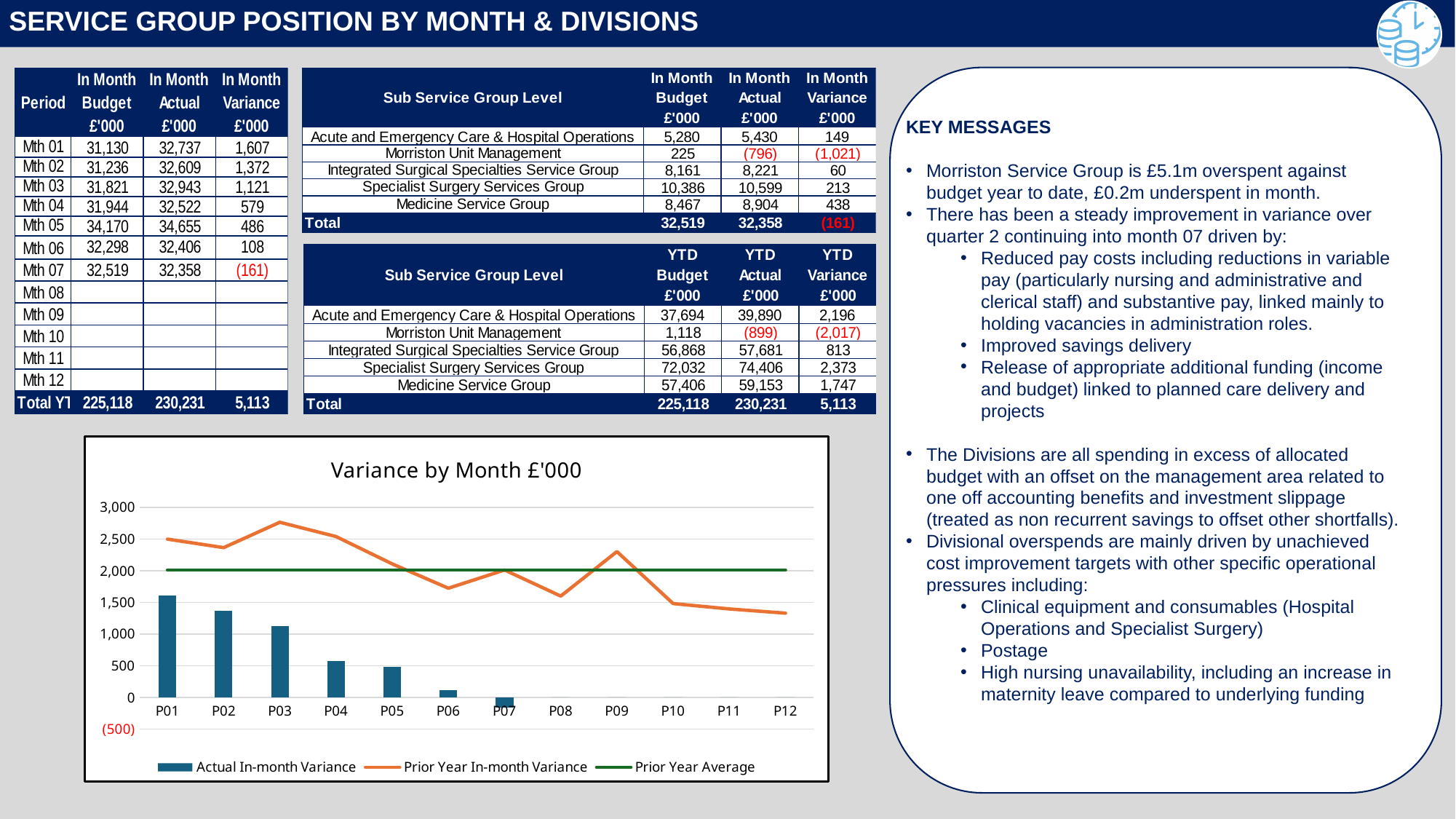
Is the Prior Year In-month Variance for P03 greater or less than 2,500? greater How many period categories are shown on the x axis of the chart? 12 Which period has the lowest Actual In-month Variance bar? P07 What is the title of the chart on the slide? Variance by Month £'000 What type of chart is used for the Actual In-month Variance series? bar chart Is the Actual In-month Variance for P01 greater or less than 1,500? greater Is the Actual In-month Variance for P07 greater or less than 0? less Which period has the highest Prior Year In-month Variance? P03 How many series does the chart legend list? 3 Which is larger, the Prior Year In-month Variance for P08 or for P09? P09 Which period has the highest Actual In-month Variance bar? P01 Do the Actual In-month Variance bars rise or fall from P01 to P07? fall